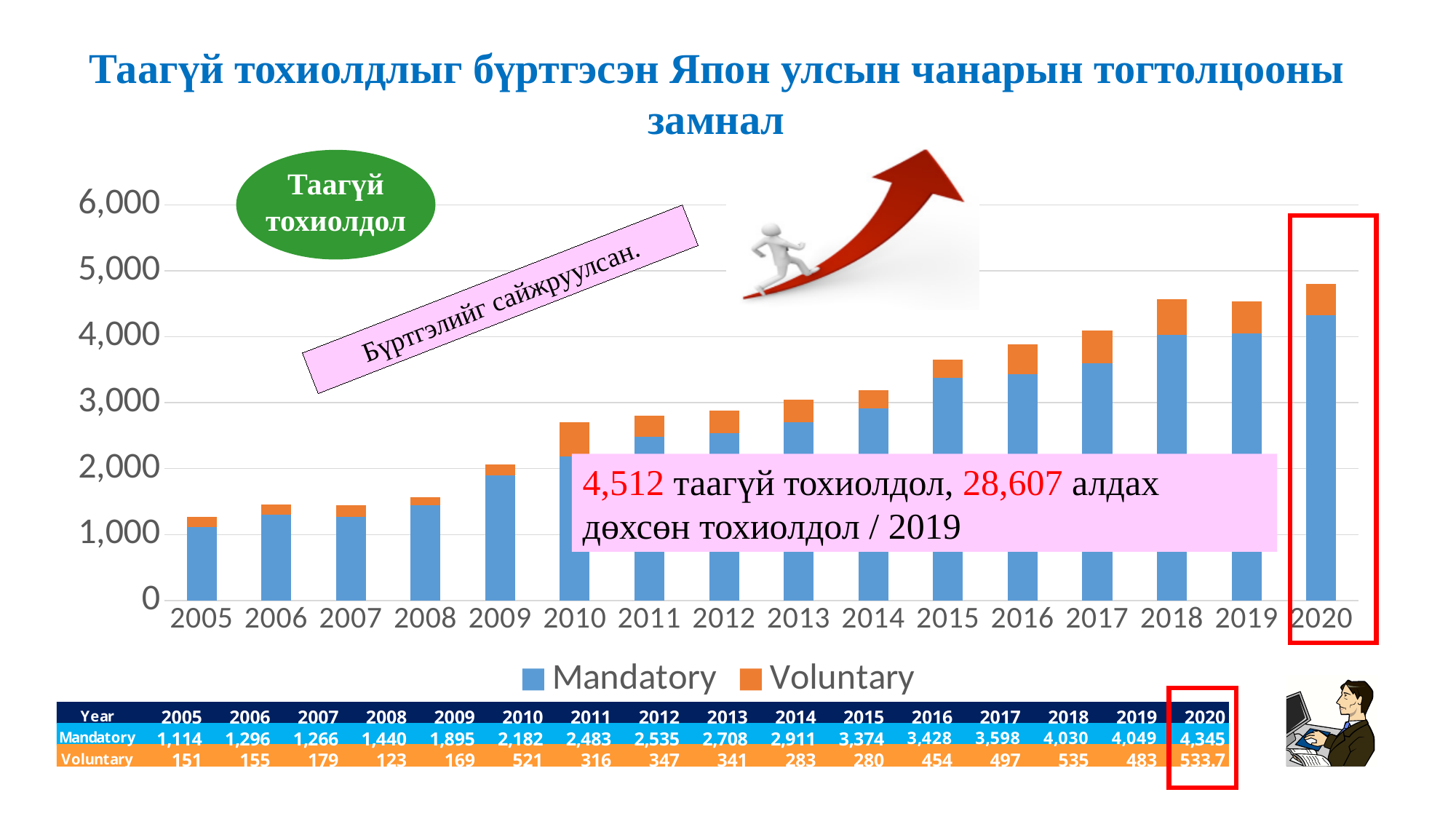
What is the difference between the Mandatory values for 2020 and 2019? 296 How many years are plotted on the x axis of the chart? 16 What type of chart is shown on the slide? Stacked bar chart Which is larger, the Voluntary value for 2016 or for 2014? 2016 Is the total stacked bar for 2015 greater or less than 3,000? greater Do the Mandatory values generally rise or fall from 2005 to 2020? rise What is the Voluntary value for 2010? 521 Which year has the highest Mandatory value? 2020 What is the total of the stacked bar for 2005? 1,265 Which year has the lowest Voluntary value? 2008 What is the Mandatory value for 2020? 4,345 How many series does the chart legend list? 2